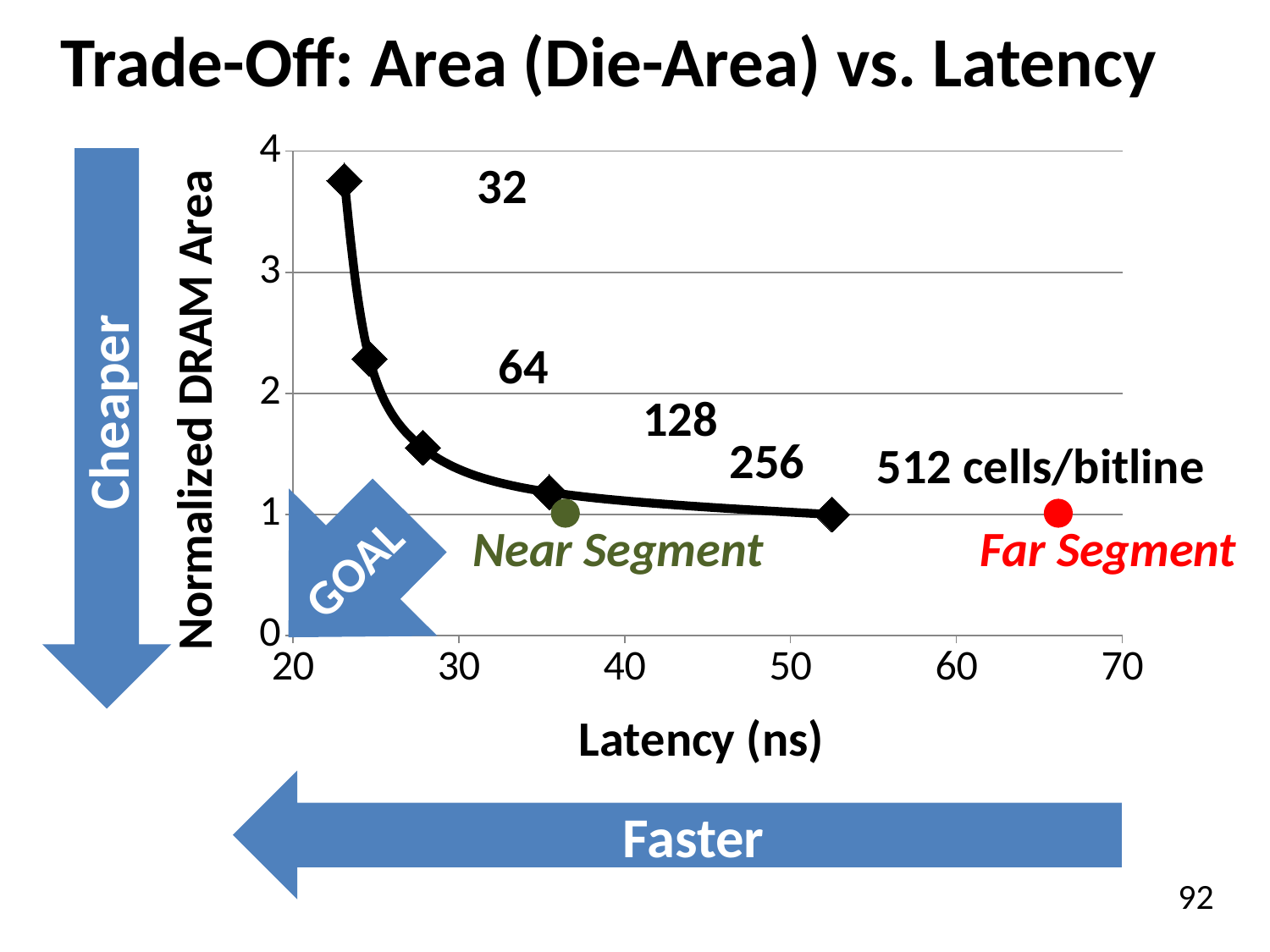
Is the normalized DRAM area for 128 cells/bitline greater or less than 2? less Is the normalized DRAM area for 32 cells/bitline greater or less than 3? greater What kind of chart is shown on the slide? line chart Which has a larger normalized DRAM area, 64 cells/bitline or 128 cells/bitline? 64 cells/bitline As latency increases along the x axis, does the normalized DRAM area rise or fall? fall How many cells/bitline configurations are plotted as points on the black curve? 5 What is the title of the y axis? Normalized DRAM Area Which cells/bitline configuration has the lowest normalized DRAM area? 512 Is the latency of the Far Segment point greater or less than 60 ns? greater Which cells/bitline configuration has the highest normalized DRAM area? 32 What is the title of the x axis? Latency (ns)